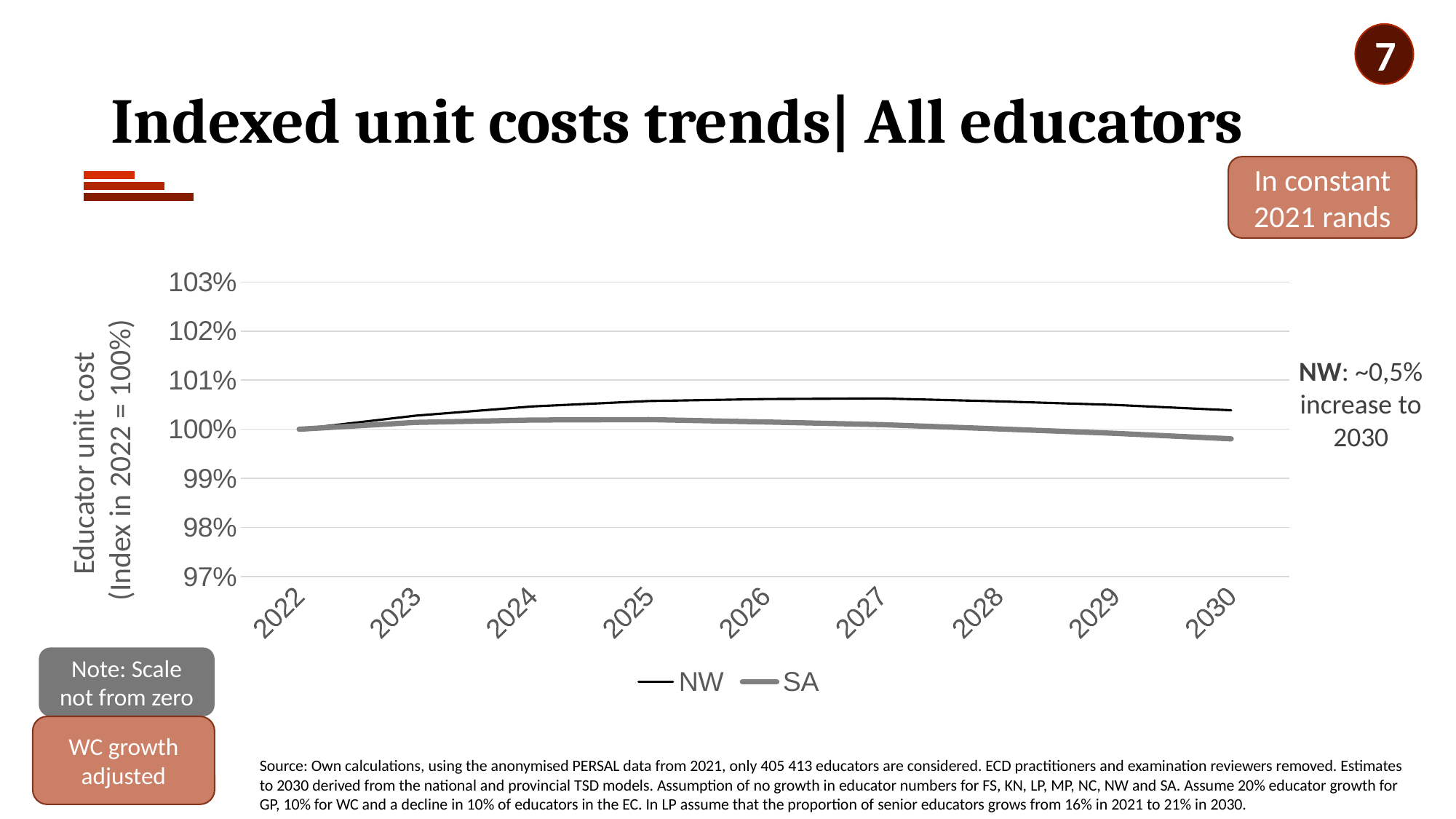
Does the SA line end in 2030 above or below its starting level in 2022? below What kind of chart is shown on the slide? line chart In 2030, which series has the higher value, NW or SA? NW Is the value for NW in 2027 greater or less than 101%? less Which two series are listed in the chart legend? NW and SA What is the first year shown on the x axis? 2022 How many series does the chart legend list? 2 What is the indexed unit cost value for both NW and SA in 2022? 100% Is the value for NW in 2030 greater or less than 100%? greater Is the value for SA in 2030 greater or less than 100%? less Does the NW line rise or fall between 2027 and 2030? fall How many years are shown along the x axis of the chart? 9